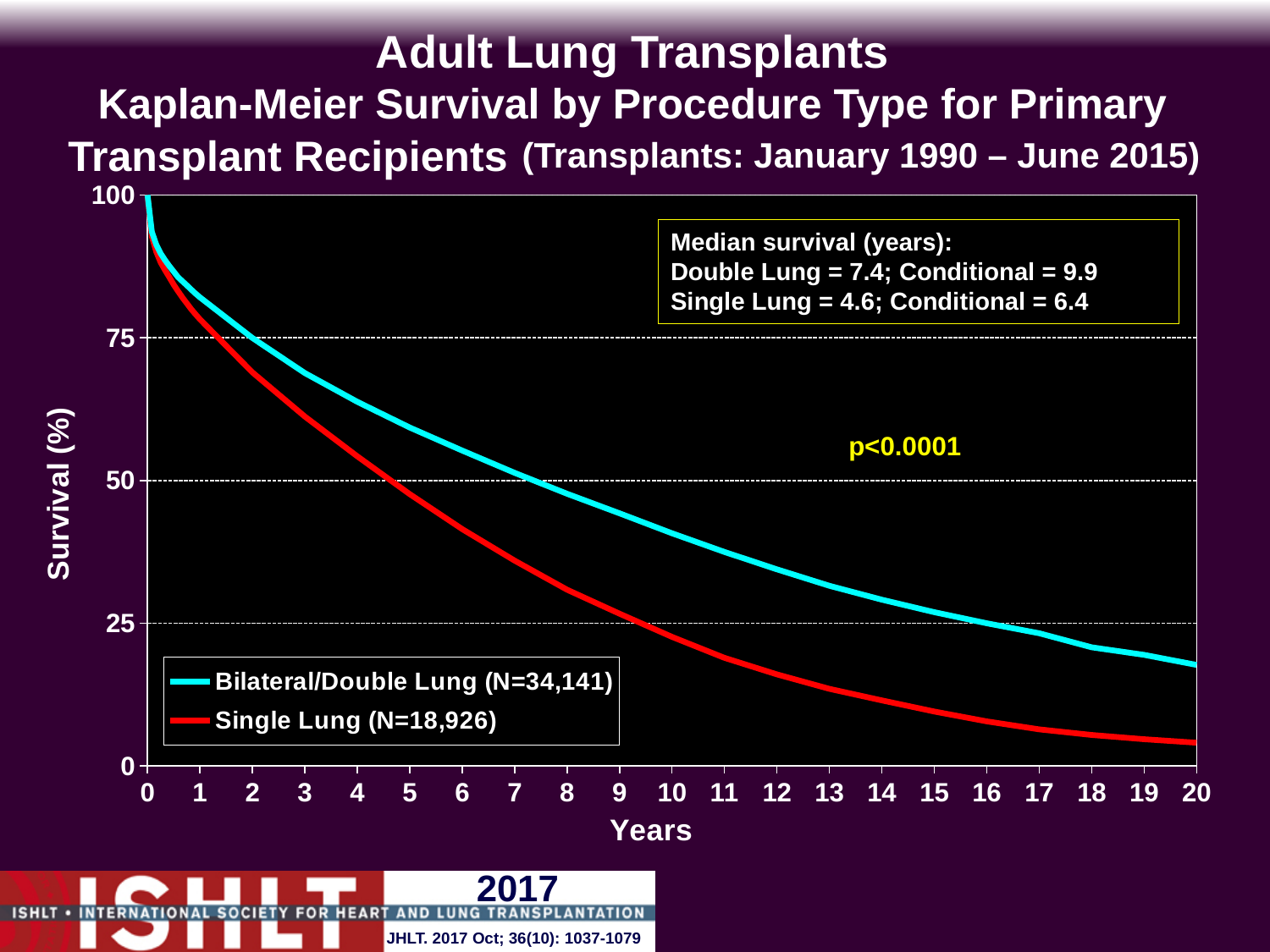
Is the survival for Single Lung at 1 year greater or less than 75? greater Is the survival for Bilateral/Double Lung at 10 years greater or less than 50? less What kind of chart is shown on the slide? line chart What is the median survival in years for Double Lung recipients? 7.4 Do the survival curves rise or fall as years increase? fall What is the N for the Bilateral/Double Lung group shown in the legend? 34,141 How many series does the legend list? 2 What is the median survival in years for Single Lung recipients? 4.6 At 10 years, which series has the higher survival, Bilateral/Double Lung or Single Lung? Bilateral/Double Lung What is the conditional median survival in years for Single Lung recipients? 6.4 What is the conditional median survival in years for Double Lung recipients? 9.9 Is the survival for Single Lung at 10 years greater or less than 25? less